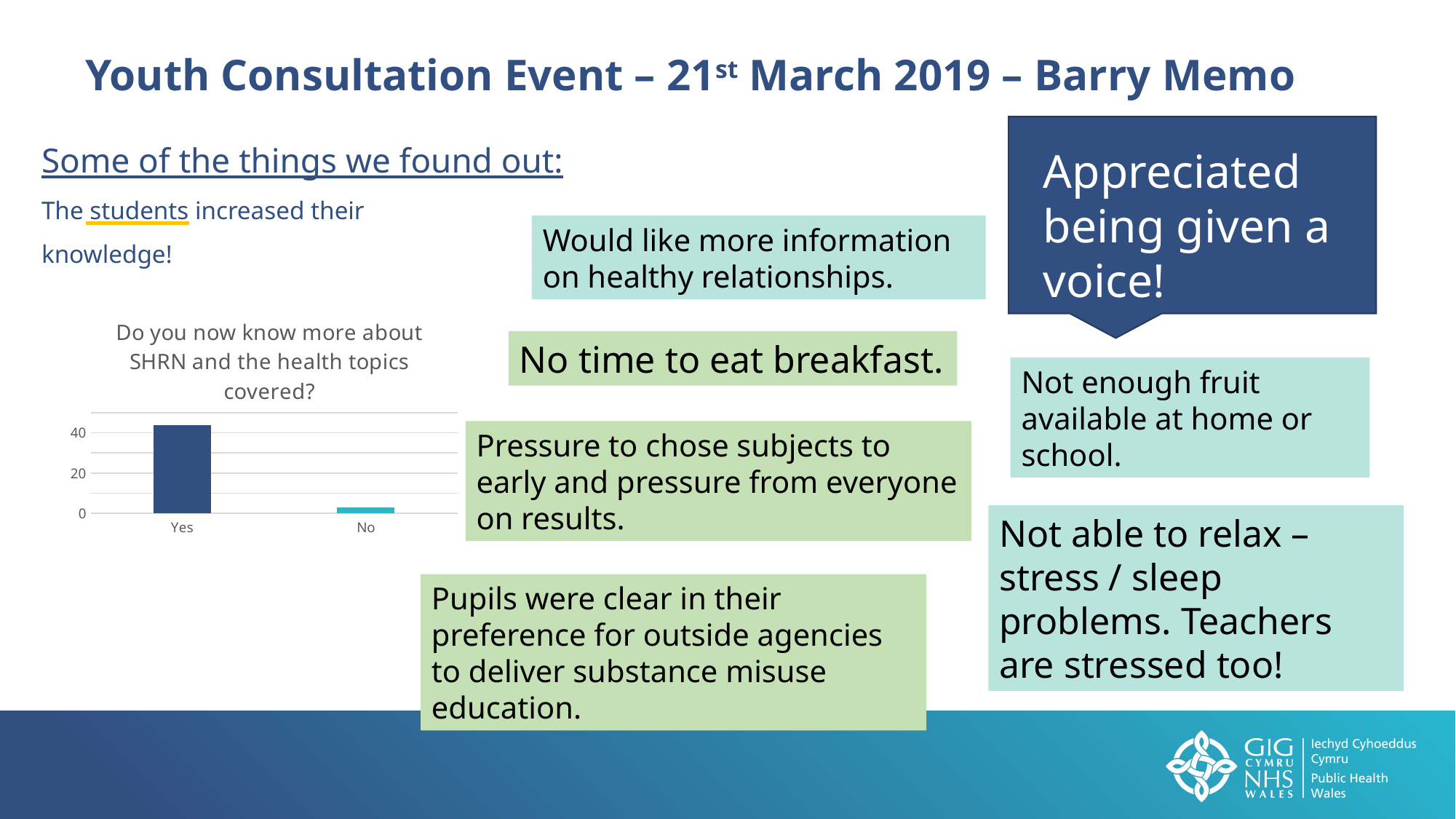
Is the value for No greater or less than 20? less Which category has the lowest bar in the chart? No What is the highest value labelled on the chart's y axis? 40 What is the title of the chart? Do you now know more about SHRN and the health topics covered? How many categories are shown on the x axis of the chart? 2 Do the values rise or fall moving from Yes to No along the x axis? fall Which is larger in the chart, the value for Yes or the value for No? Yes Which category has the highest bar in the chart? Yes What kind of chart is shown on the slide? bar chart Is the value for Yes greater or less than 20? greater